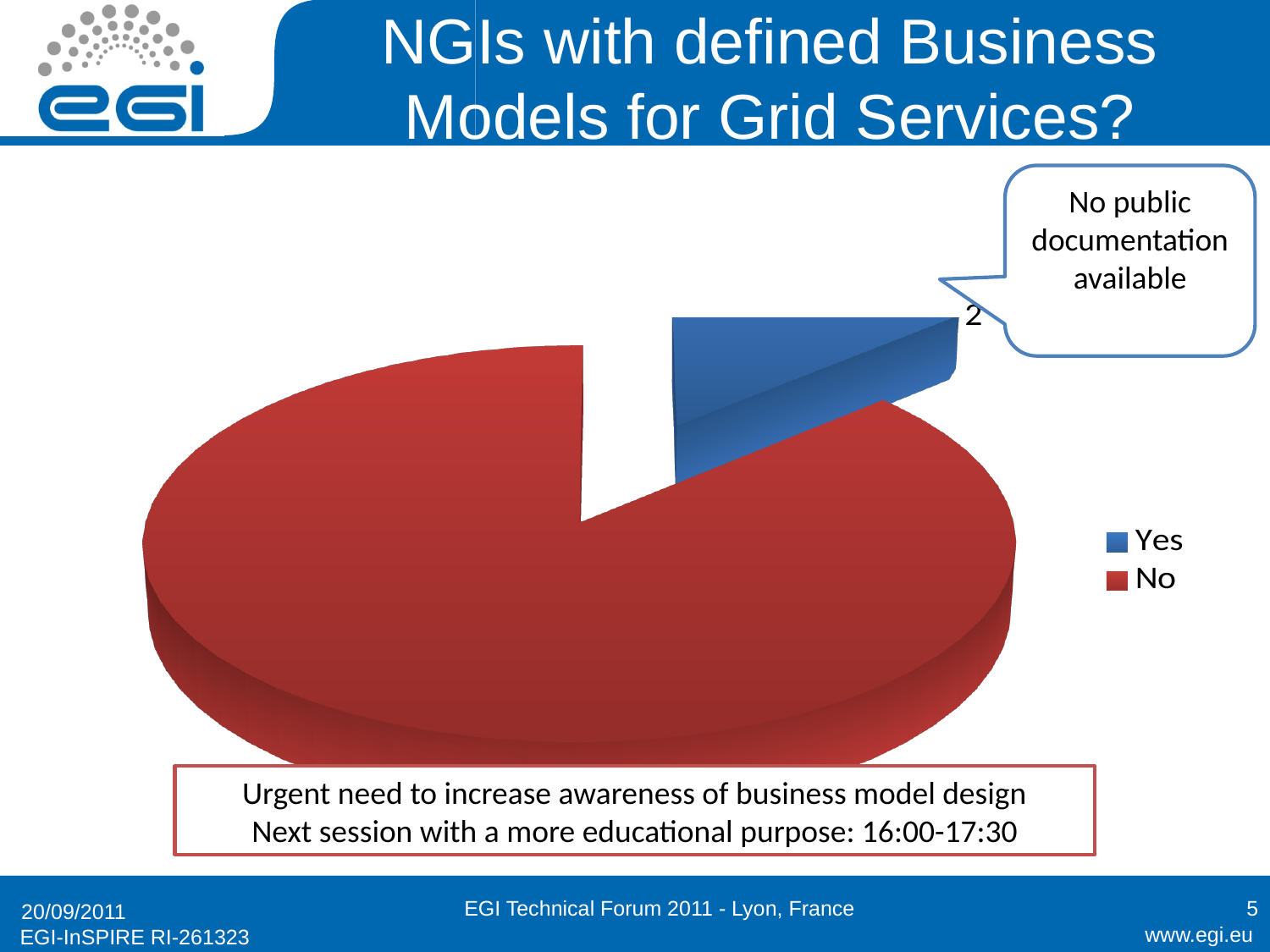
What colour is the "No" slice in the pie chart? Red What type of chart is shown on the slide? Pie chart Which slice is larger in the pie chart, "Yes" or "No"? No How many entries does the legend of the pie chart list? 2 What is the value shown for the "Yes" slice of the pie chart? 2 How many categories (slices) does the pie chart have? 2 Which category has the largest slice in the pie chart? No Which category has the smallest slice in the pie chart? Yes What is the title of the slide containing the pie chart? NGIs with defined Business Models for Grid Services?